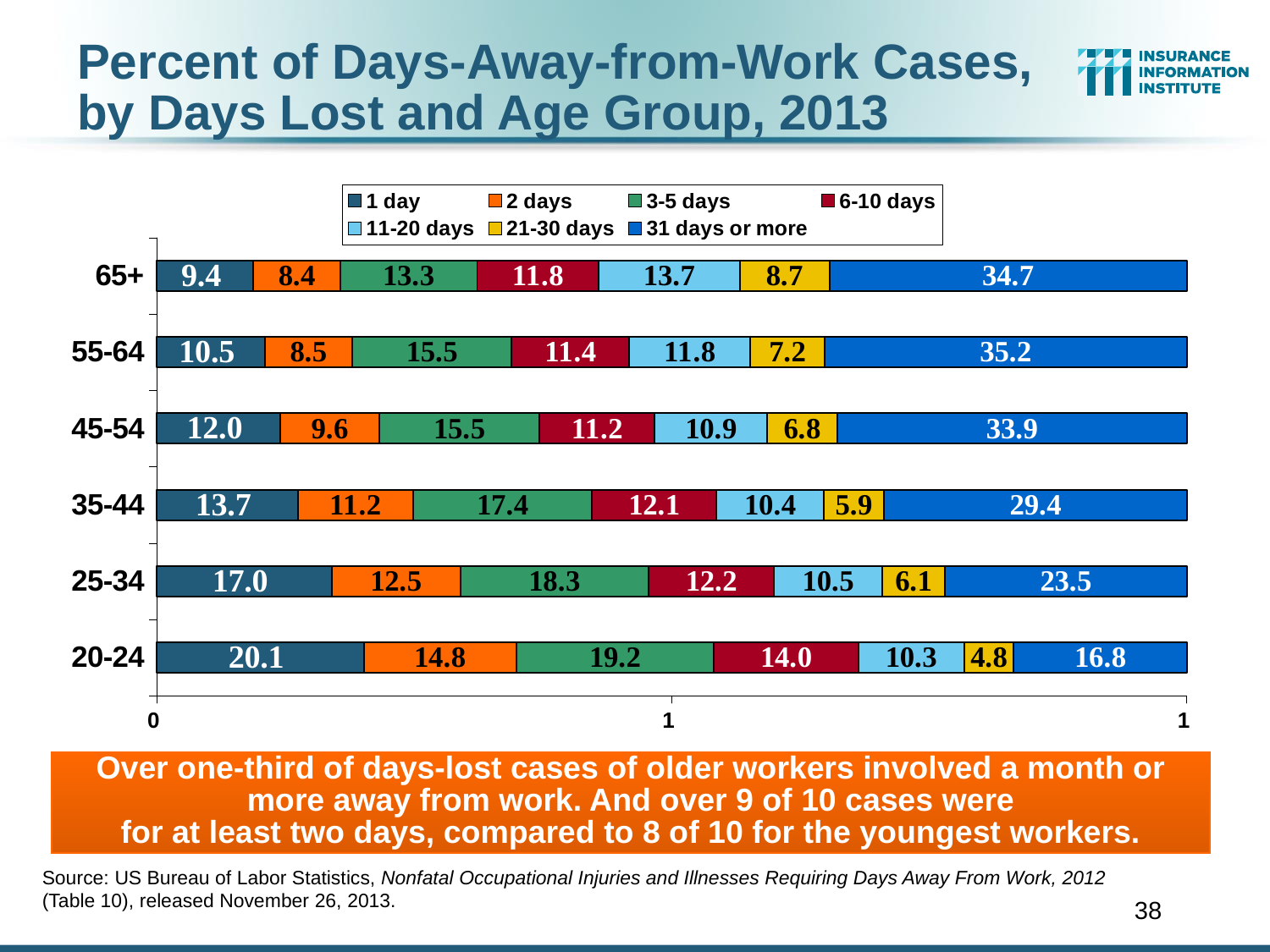
What is the value for the 31 days or more segment in the 65+ age group? 34.7 What is the value for the 1 day segment in the 20-24 age group? 20.1 Which has the larger 2 days value, the 25-34 group or the 35-44 group? 25-34 What is the value for the 21-30 days segment in the 35-44 age group? 5.9 What is the difference between the 31 days or more values for the 65+ group and the 20-24 group? 17.9 Which age group has the highest value for the 1 day segment? 20-24 How many series does the legend list? 7 What kind of chart is shown on the slide? Stacked bar chart What is the total of the segments in the 20-24 bar? 100.0 Which age group has the lowest value for the 21-30 days segment? 20-24 What is the value for the 3-5 days segment in the 45-54 age group? 15.5 How many age groups are shown in the chart? 6